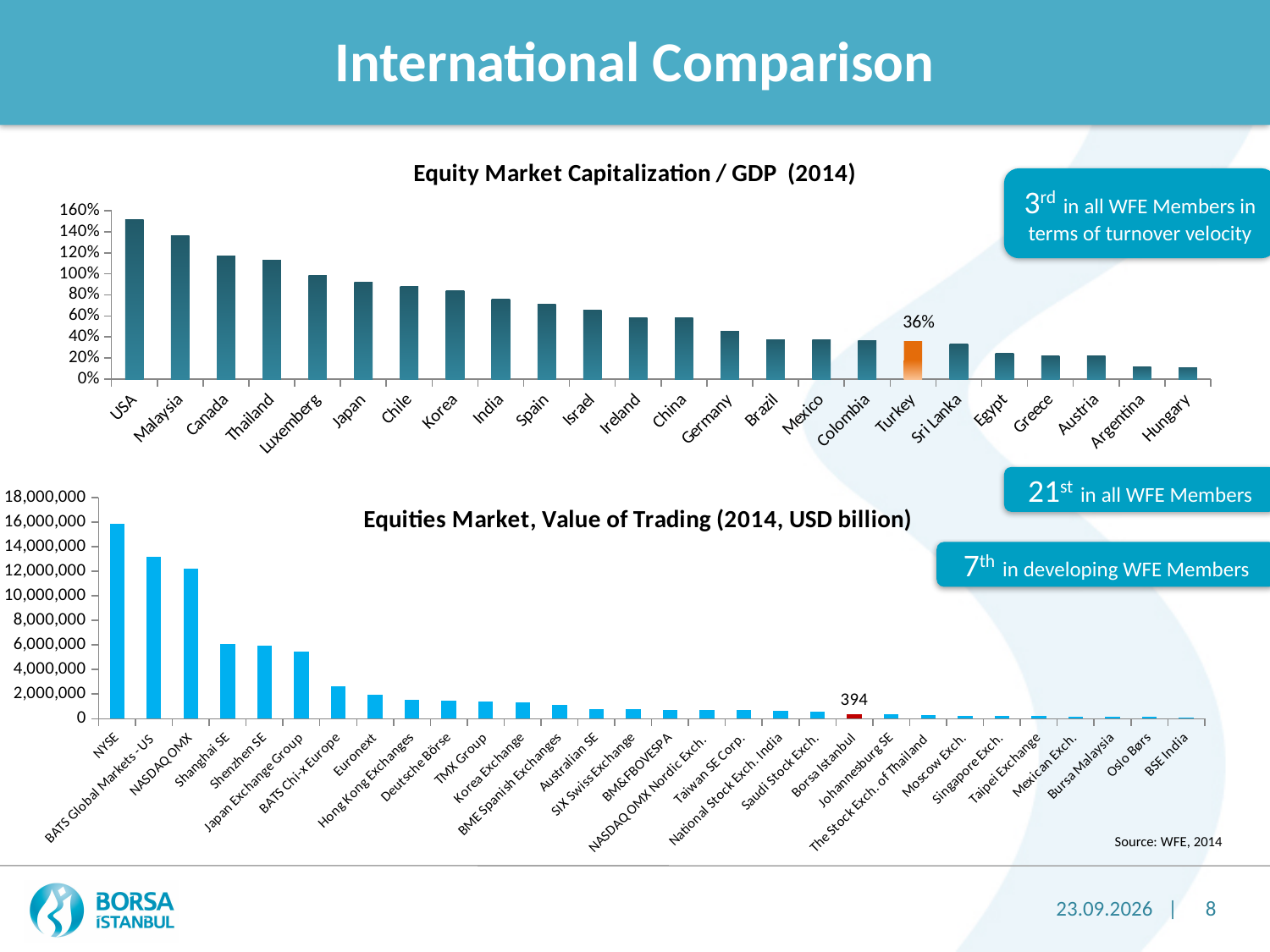
In the Equity Market Capitalization / GDP (2014) chart, which country is larger, Malaysia or Canada? Malaysia In the Equities Market, Value of Trading (2014, USD billion) chart, do the values rise or fall from left to right? Fall In the Equity Market Capitalization / GDP (2014) chart, is the value for Malaysia greater or less than 140%? less In the Equities Market, Value of Trading (2014, USD billion) chart, what is the value for Borsa Istanbul? 394 In the Equity Market Capitalization / GDP (2014) chart, which country has the highest value? USA How many countries are shown in the Equity Market Capitalization / GDP (2014) chart? 24 What type of chart is the Equity Market Capitalization / GDP (2014) chart? Bar chart In the Equity Market Capitalization / GDP (2014) chart, what is the value for Turkey? 36% How many exchanges are shown in the Equities Market, Value of Trading (2014, USD billion) chart? 30 In the Equities Market, Value of Trading (2014, USD billion) chart, which exchange has the highest value? NYSE In the Equities Market, Value of Trading (2014, USD billion) chart, is the value for Shanghai SE greater or less than 8,000,000? less In the Equities Market, Value of Trading (2014, USD billion) chart, is the value for NYSE greater or less than 14,000,000? greater